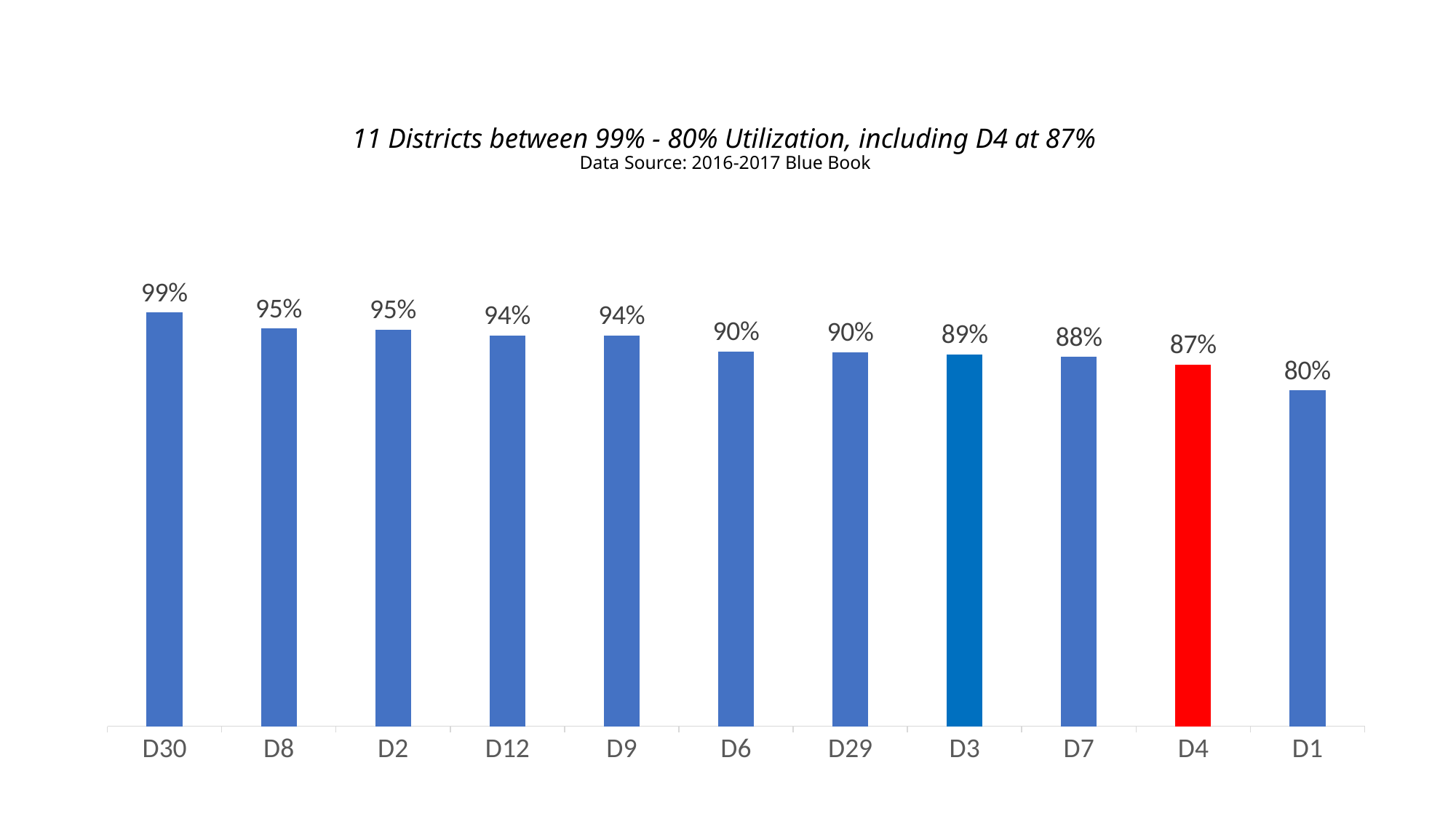
What is the utilization value for D4? 87% What kind of chart is shown on the slide? Bar chart What is the utilization value for D12? 94% Which district's bar is coloured red? D4 What is the utilization value for D29? 90% Do the values rise or fall from left to right along the x axis? Fall Which district has the highest utilization? D30 What is the difference between the utilization of D8 and D4? 8% Which has a higher utilization, D3 or D1? D3 Which district has the lowest utilization? D1 How many districts are shown in the chart? 11 What is the difference between the utilization of D30 and D1? 19%